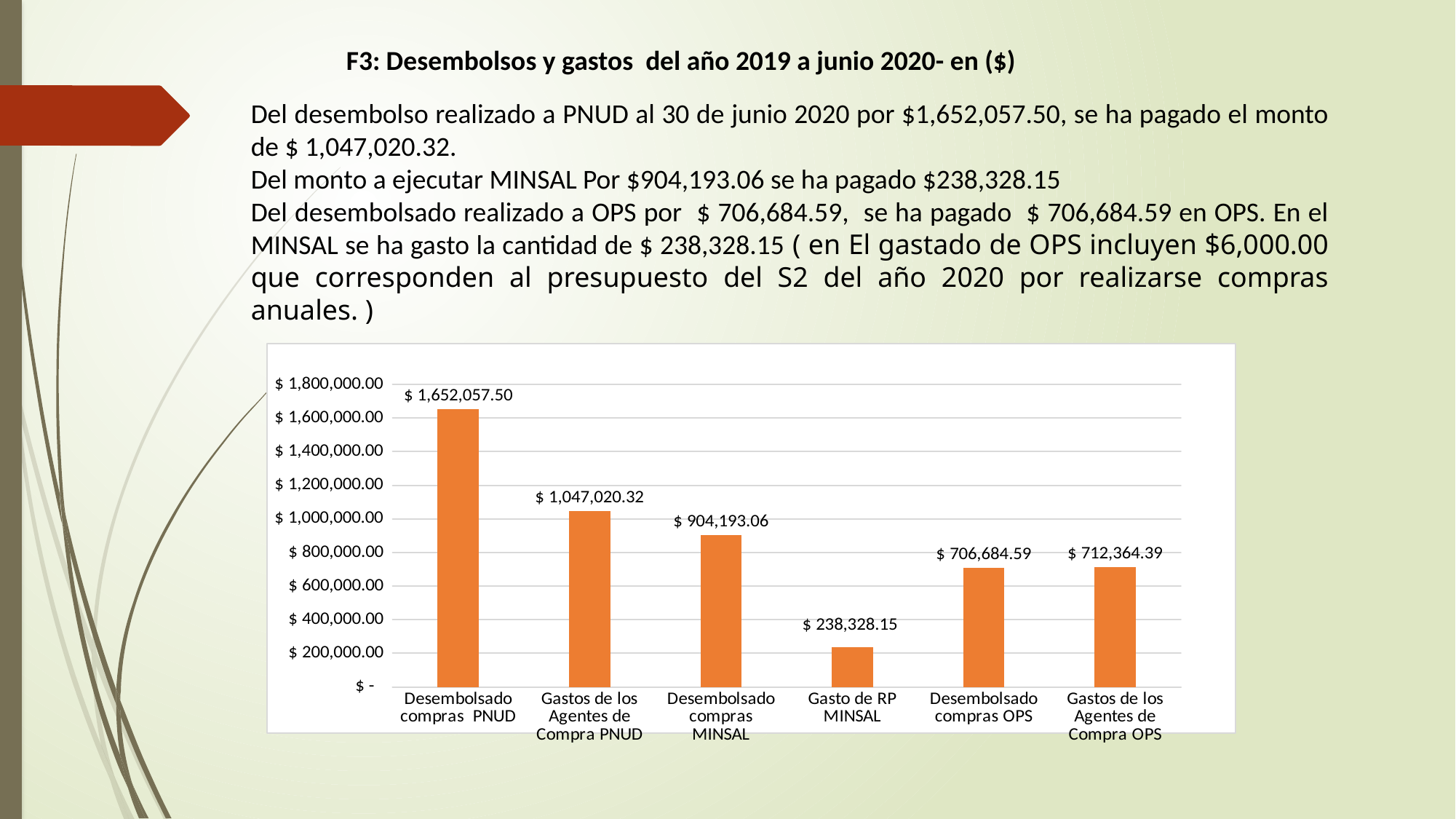
What is the difference between Desembolsado compras MINSAL and Gasto de RP MINSAL? $ 665,864.91 What kind of chart is shown on the slide? Bar chart What is the value for Desembolsado compras MINSAL? $ 904,193.06 How many categories are shown in the chart? 6 What is the value for Gastos de los Agentes de Compra OPS? $ 712,364.39 Which is larger, Desembolsado compras MINSAL or Desembolsado compras OPS? Desembolsado compras MINSAL What is the difference between Desembolsado compras PNUD and Gastos de los Agentes de Compra PNUD? $ 605,037.18 Which category has the lowest value? Gasto de RP MINSAL What is the value for Desembolsado compras PNUD? $ 1,652,057.50 What is the value for Gastos de los Agentes de Compra PNUD? $ 1,047,020.32 What is the value for Gasto de RP MINSAL? $ 238,328.15 Which category has the highest value? Desembolsado compras PNUD